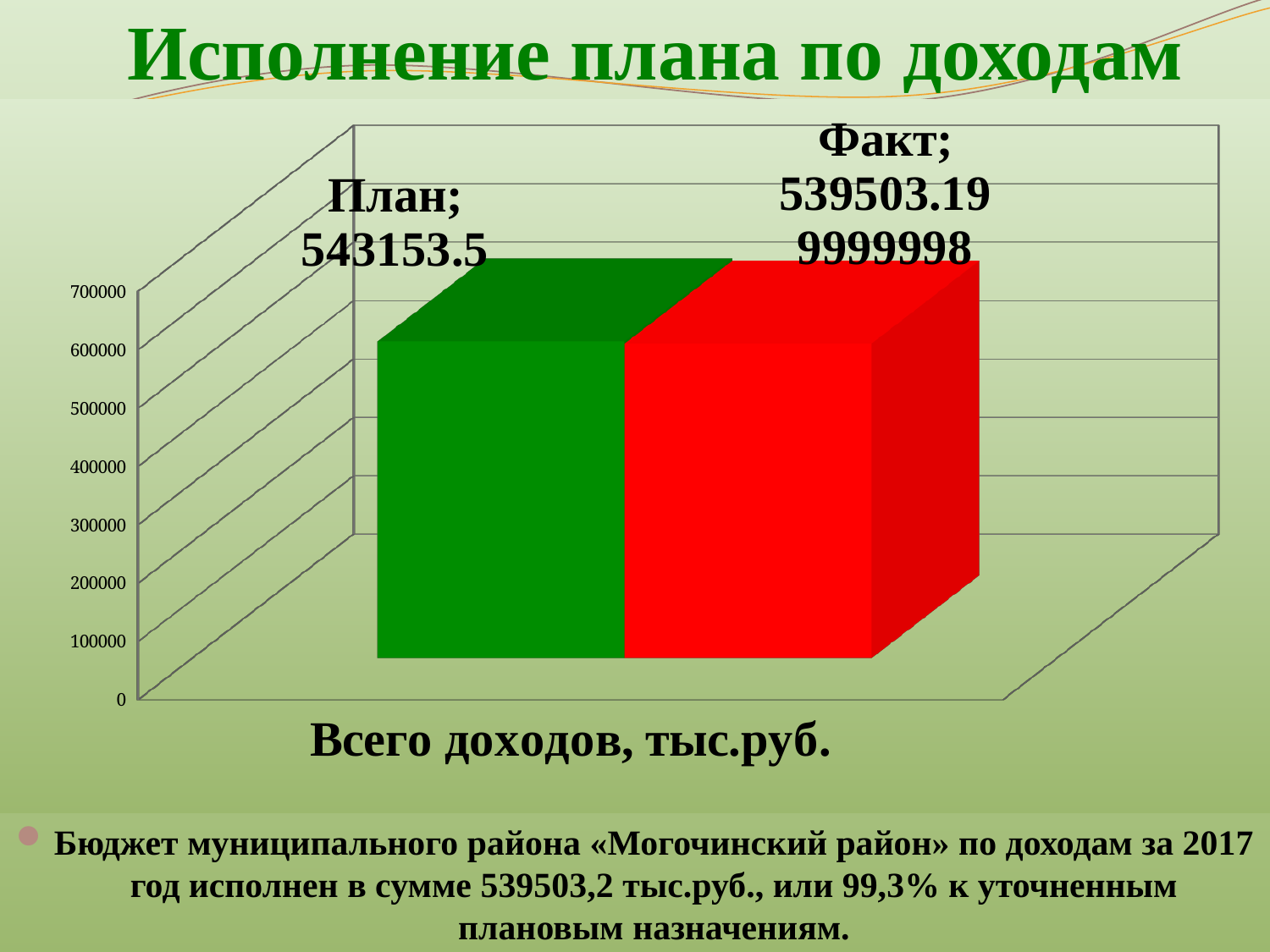
What kind of chart is shown on the slide? Bar chart How many bars are plotted on the chart? 2 Is the value for Факт greater or less than 600000? less Is the value for План greater or less than 500000? greater Is the value for Факт greater or less than 400000? greater What is the value of the Факт bar? 539503.199999998 What is the value of the План bar? 543153.5 What is the label on the category axis of the chart? Всего доходов, тыс.руб. What is the highest value shown on the vertical axis of the chart? 700000